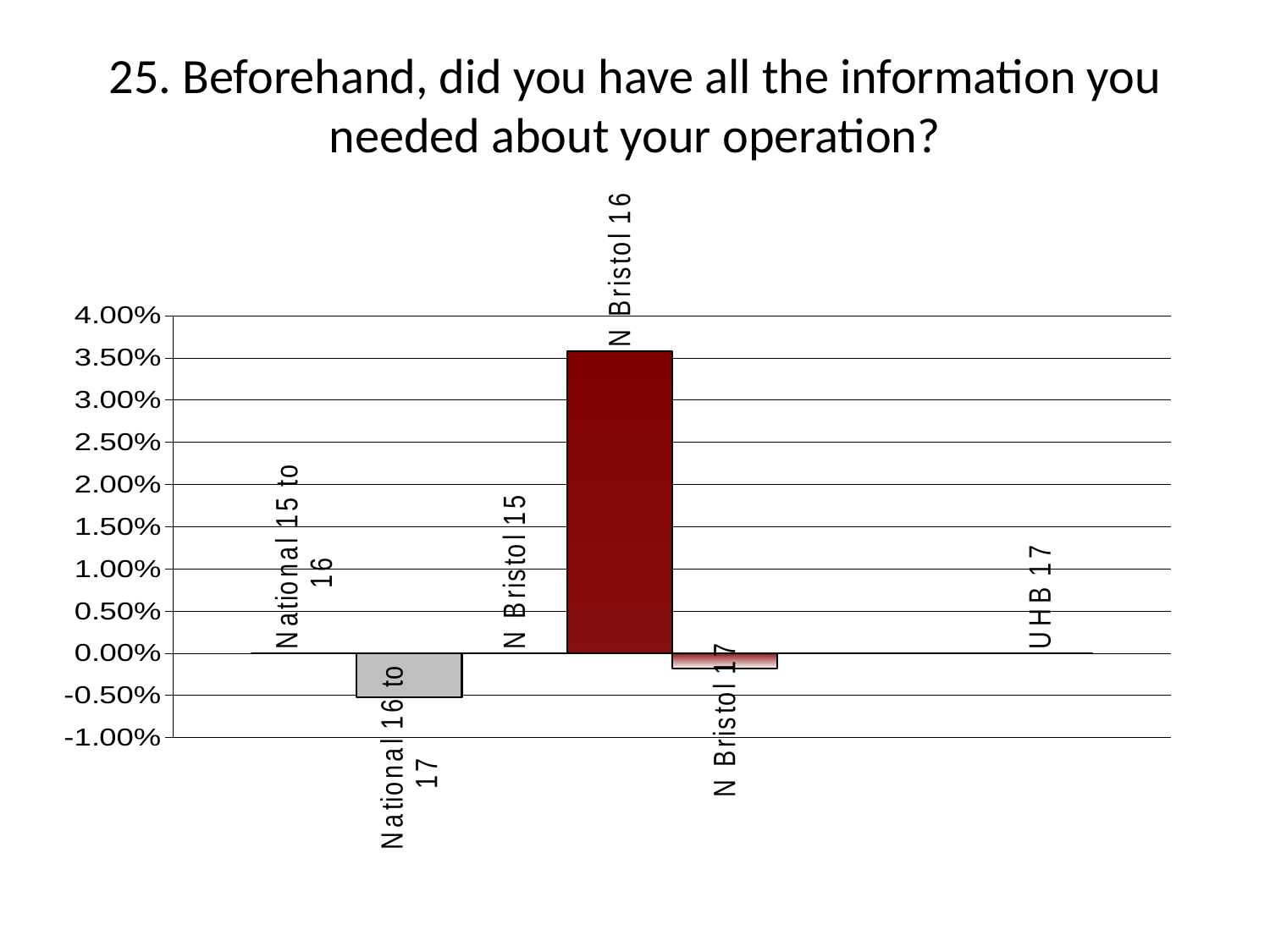
Is the value for N Bristol 17 greater or less than -0.50%? greater How many bars in the chart extend below 0.00%? 2 Is the value for N Bristol 16 greater or less than 4.00%? less How many categories are shown on the x axis of the chart? 6 What is the title of the slide containing the chart? 25. Beforehand, did you have all the information you needed about your operation? What kind of chart is shown on the slide? bar chart Which category has the lowest value in the chart? National 16 to 17 Which category has the highest value in the chart? N Bristol 16 Is the value for National 16 to 17 greater or less than 0.00%? less Which is larger, the value for N Bristol 16 or the value for National 16 to 17? N Bristol 16 Which is larger, the value for N Bristol 17 or the value for National 16 to 17? N Bristol 17